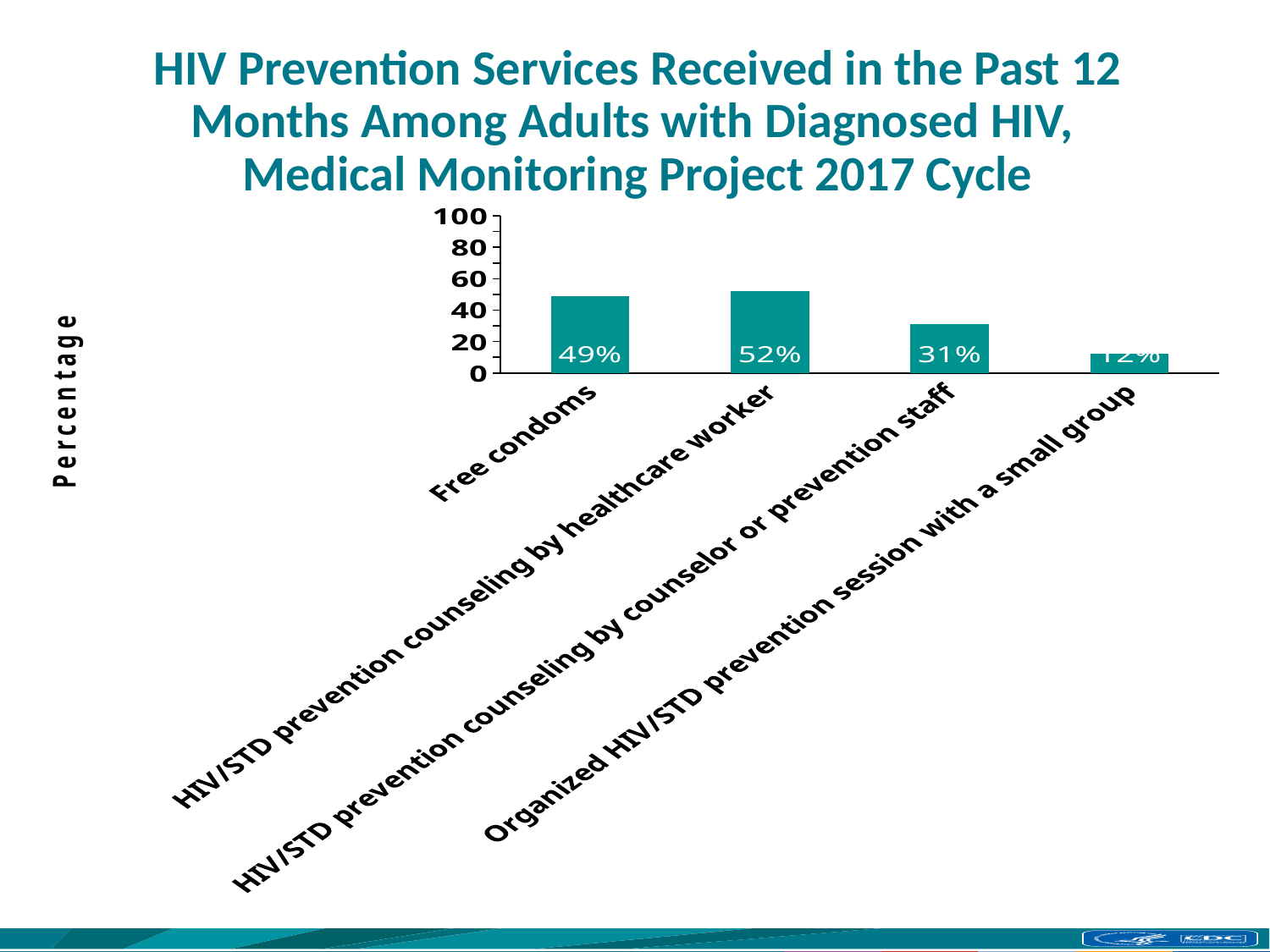
Which service has the highest percentage? HIV/STD prevention counseling by healthcare worker What is the label on the vertical axis of the chart? Percentage What is the value for HIV/STD prevention counseling by counselor or prevention staff? 31% Is the value for Organized HIV/STD prevention session with a small group greater or less than 20? less What is the difference between the percentage for free condoms and the percentage for HIV/STD prevention counseling by counselor or prevention staff? 18% How many service categories are shown in the chart? 4 Which is larger: the value for free condoms or the value for HIV/STD prevention counseling by counselor or prevention staff? Free condoms What is the difference between the percentage for HIV/STD prevention counseling by healthcare worker and the percentage for free condoms? 3% Which service has the lowest percentage? Organized HIV/STD prevention session with a small group What type of chart is shown on the slide? Bar chart What is the value for HIV/STD prevention counseling by healthcare worker? 52% What percentage of adults with diagnosed HIV received free condoms? 49%